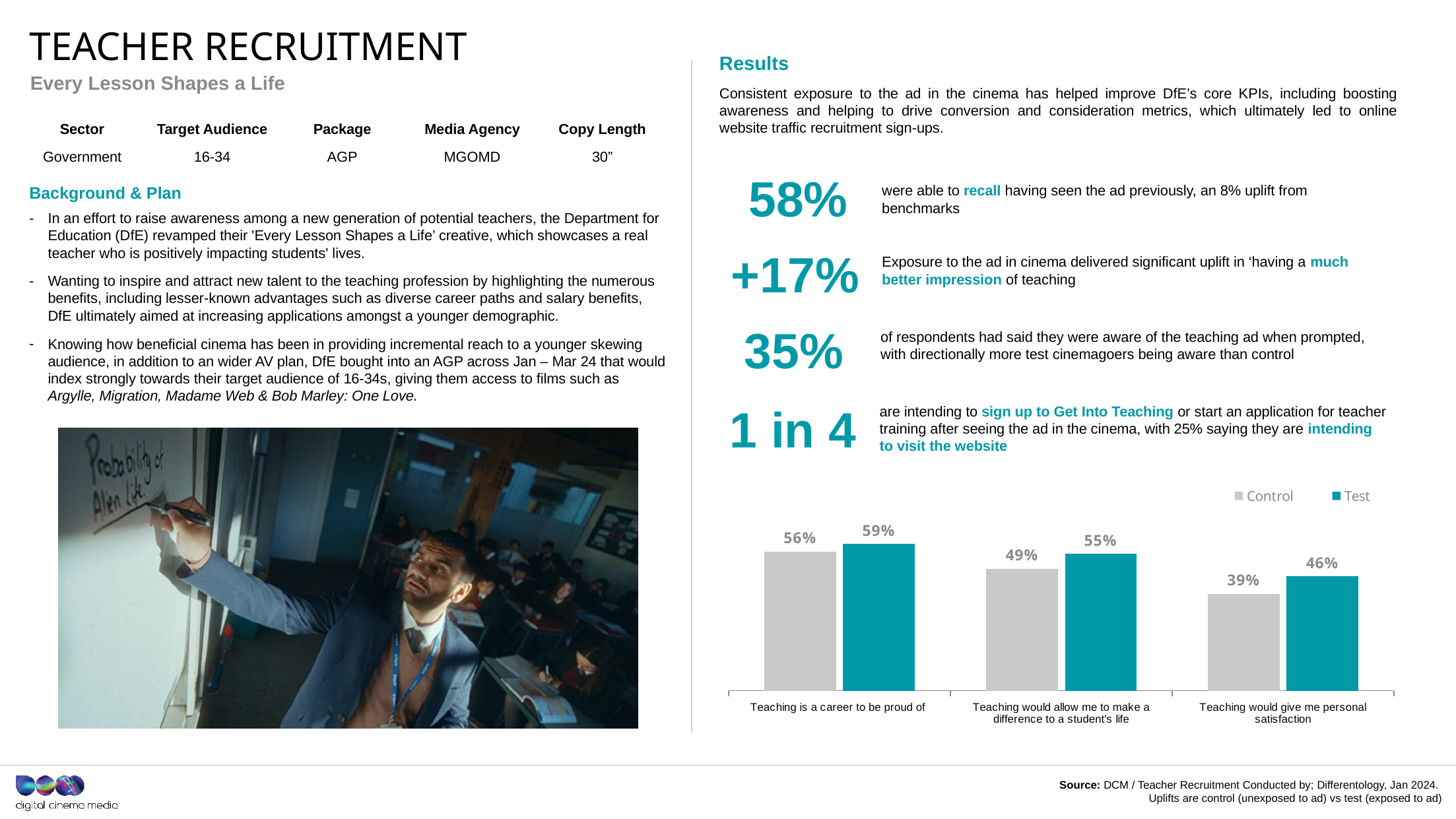
What is the Test value for 'Teaching is a career to be proud of'? 59% What kind of chart is shown on the slide? Bar chart Which category has the lowest Control value? Teaching would give me personal satisfaction What is the Control value for 'Teaching would give me personal satisfaction'? 39% How many categories are shown on the x axis of the chart? 3 How many series does the chart legend list? 2 What is the difference between the Test and Control values for 'Teaching would allow me to make a difference to a student's life'? 6% What is the difference between the Test and Control values for 'Teaching would give me personal satisfaction'? 7% Which is larger for 'Teaching is a career to be proud of': the Control value or the Test value? Test Which colour represents the Test series in the chart? Teal Which category has the highest Test value? Teaching is a career to be proud of What is the Control value for 'Teaching would allow me to make a difference to a student's life'? 49%